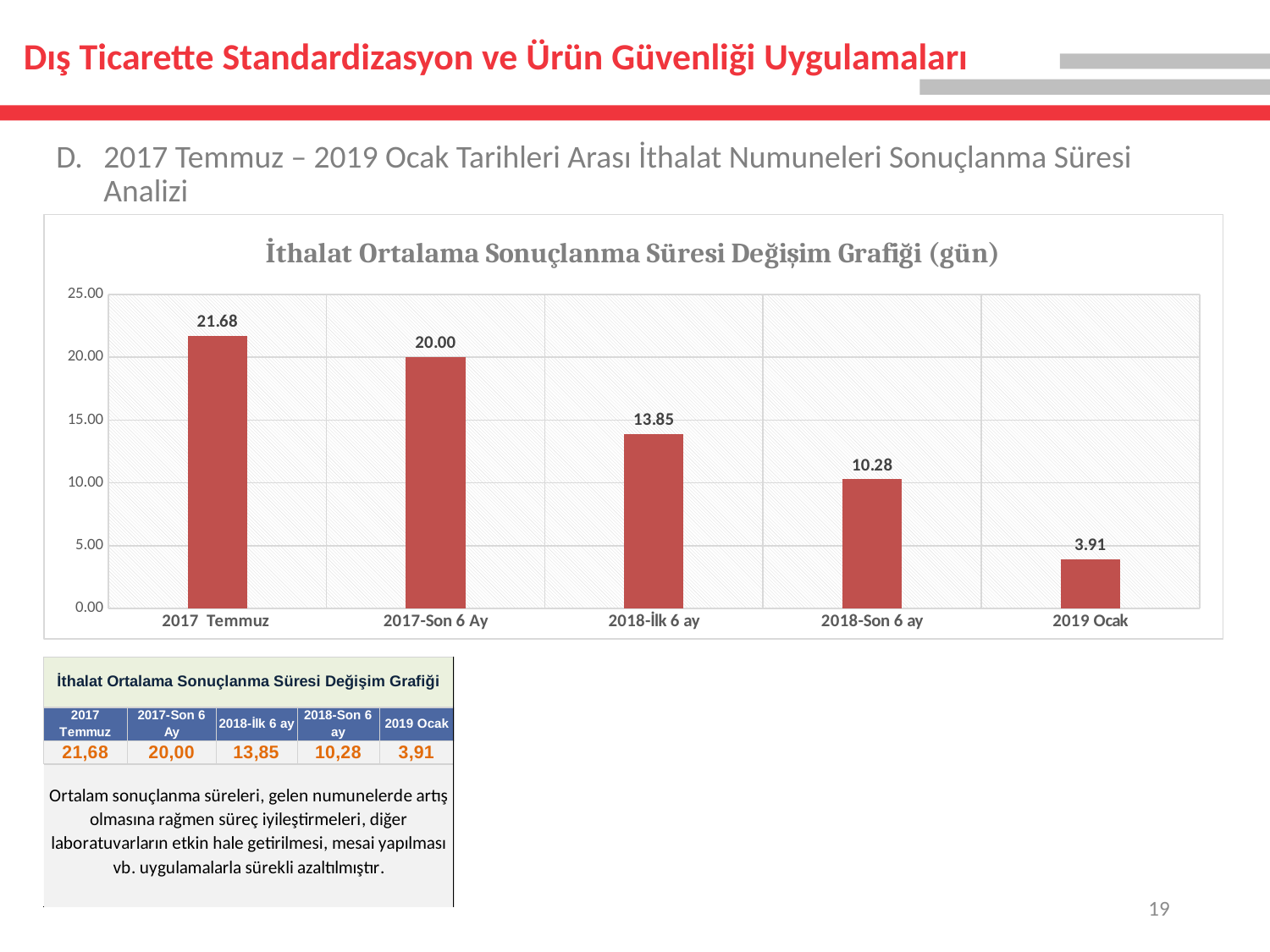
What is the difference between the values for 2017-Son 6 Ay and 2018-Son 6 ay? 9.72 Is the value for 2018-Son 6 ay greater or less than 15.00? less Which category has the highest value? 2017 Temmuz What kind of chart is shown? bar chart Which category has the lowest value? 2019 Ocak Which is larger, the value for 2018-İlk 6 ay or the value for 2018-Son 6 ay? 2018-İlk 6 ay What is the title of the chart? İthalat Ortalama Sonuçlanma Süresi Değişim Grafiği (gün) What is the value for 2019 Ocak? 3.91 Do the values rise or fall from left to right along the x axis? fall What is the value for 2018-İlk 6 ay? 13.85 What is the value for 2017 Temmuz? 21.68 How many categories are shown on the x axis? 5